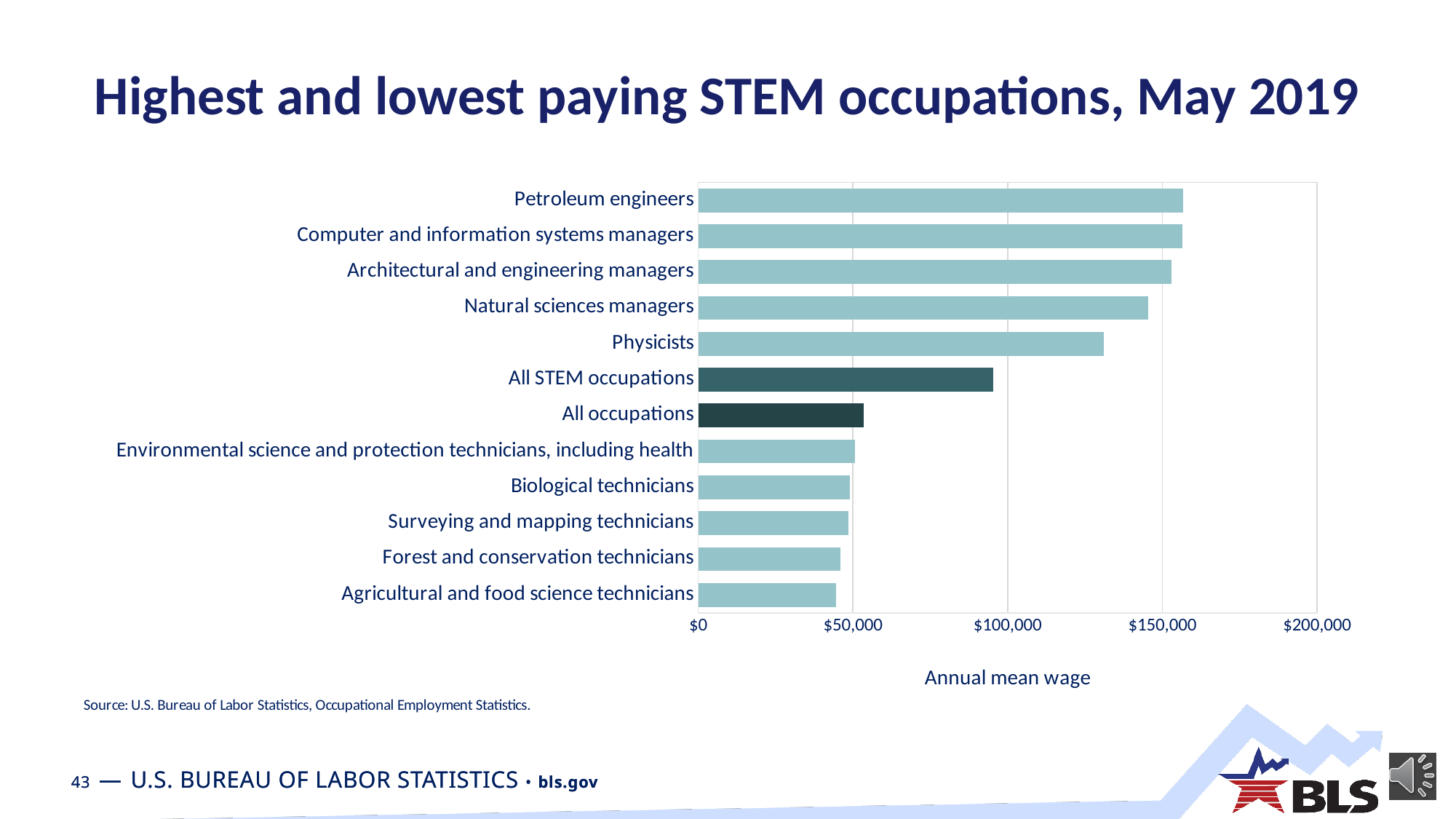
What is the title of the chart? Highest and lowest paying STEM occupations, May 2019 Which has a higher annual mean wage, Petroleum engineers or Physicists? Petroleum engineers Is the annual mean wage for Petroleum engineers greater or less than $150,000? greater What kind of chart is shown on the slide? bar chart Is the annual mean wage for Agricultural and food science technicians greater or less than $50,000? less Which has a higher annual mean wage, Natural sciences managers or Physicists? Natural sciences managers What is the label on the horizontal axis of the chart? Annual mean wage Is the annual mean wage for All STEM occupations greater or less than $50,000? greater Which has a higher annual mean wage, All STEM occupations or All occupations? All STEM occupations How many occupation categories are plotted in the chart? 12